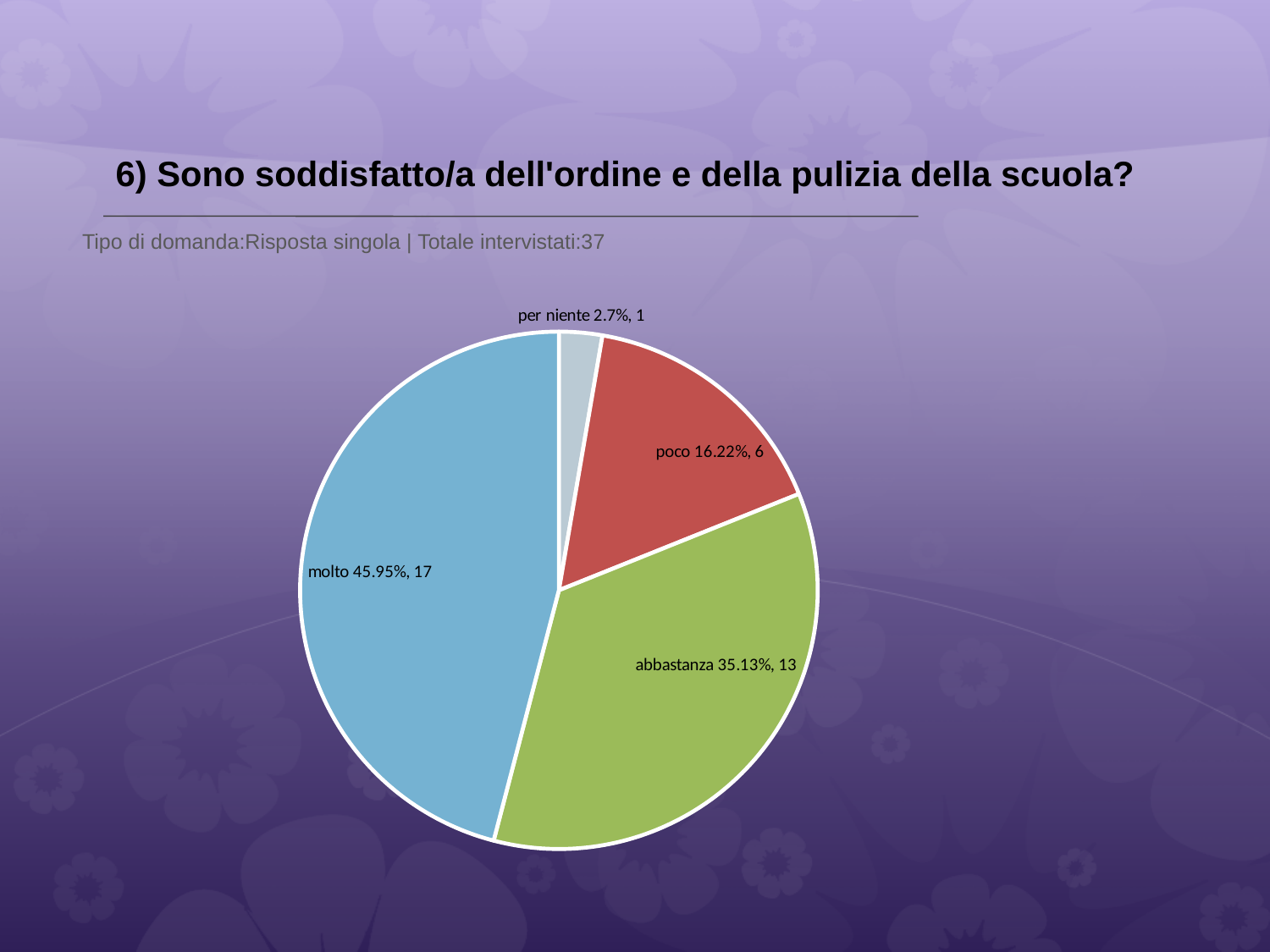
What is the total number of respondents shown on the slide? 37 What percentage share does the 'molto' slice have? 45.95% What kind of chart is shown on the slide? pie chart How many slices does the pie chart have? 4 Which category has the largest slice? molto What is the difference in respondent count between 'molto' and 'abbastanza'? 4 What colour is the 'poco' slice? red Which category has the smallest slice? per niente How many respondents answered 'per niente'? 1 What percentage share does the 'abbastanza' slice have? 35.13% How many respondents answered 'poco'? 6 Which has more respondents, 'poco' or 'abbastanza'? abbastanza